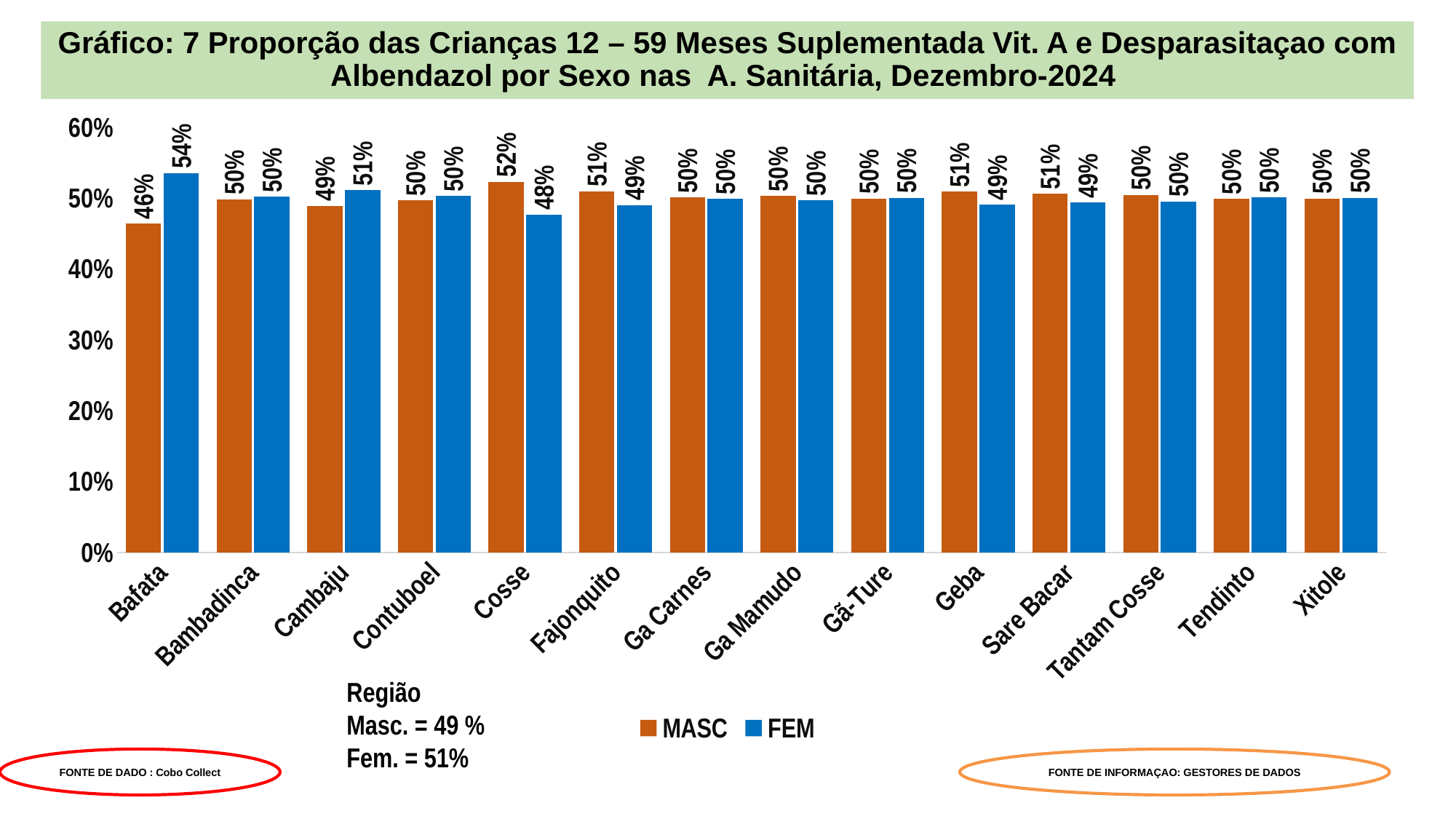
What kind of chart is shown on the slide? bar chart Which health area has the highest MASC value? Cosse What is the difference between the FEM and MASC values for Bafata? 8 percentage points Which health area has the highest FEM value? Bafata What is the FEM value for Cambaju? 51% Is the MASC value for Bafata greater or less than 50%? less Which health area has the lowest MASC value? Bafata How many health areas are shown on the x axis? 14 For Cosse, which is larger, the MASC value or the FEM value? MASC What is the MASC value for Bafata? 46% What is the FEM value for Cosse? 48% How many series does the legend list? 2